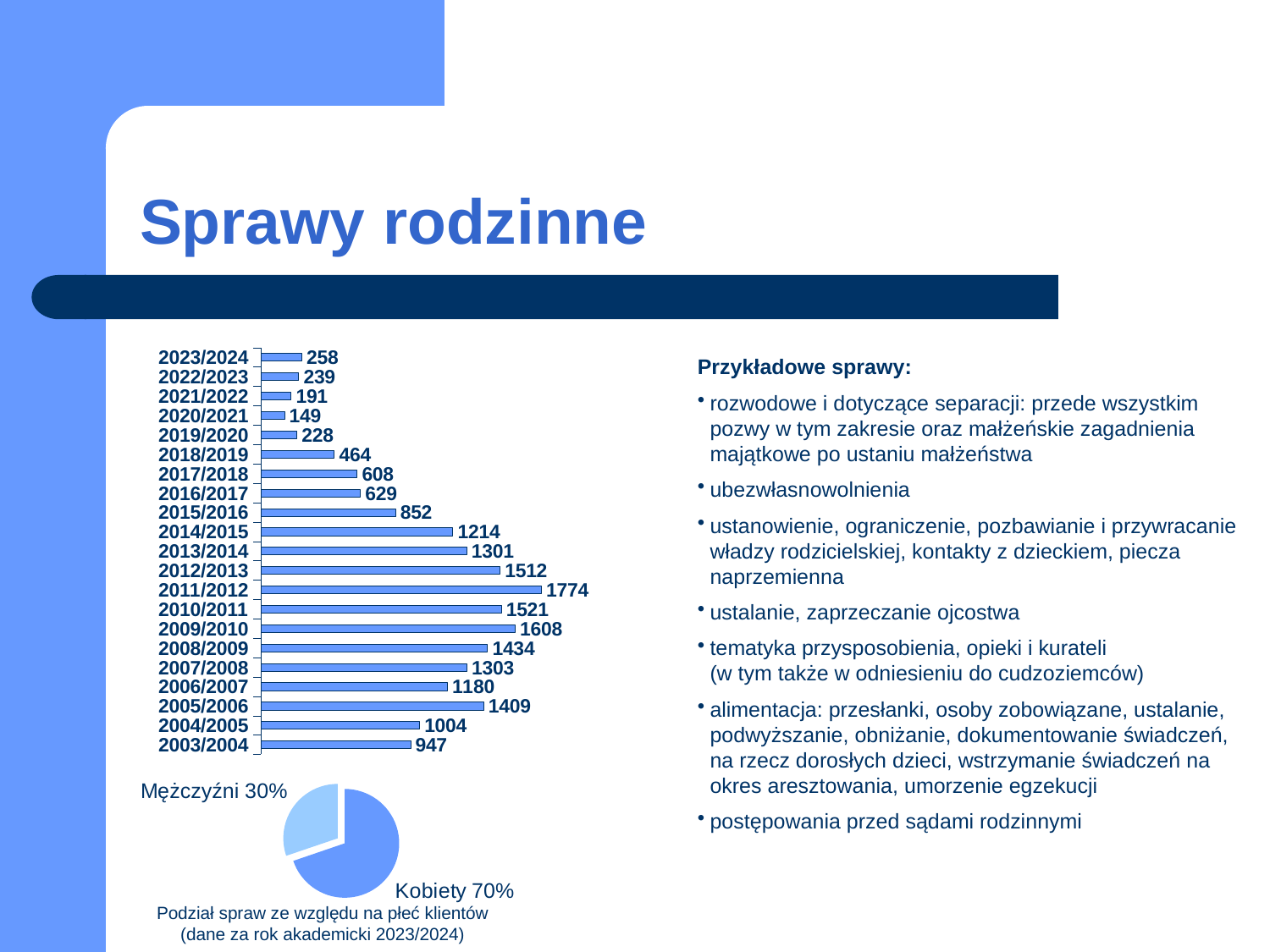
On the bar chart on the left, what is the value for 2023/2024? 258 On the bar chart on the left, what is the difference between the values for 2012/2013 and 2013/2014? 211 What is the title of the pie chart at the bottom left of the slide? Podział spraw ze względu na płeć klientów (dane za rok akademicki 2023/2024) On the bar chart on the left, what is the value for 2011/2012? 1774 How many academic years are shown on the bar chart on the left? 21 On the bar chart on the left, which is larger, the value for 2016/2017 or the value for 2017/2018? 2016/2017 On the bar chart on the left, which academic year has the lowest value? 2020/2021 On the bar chart on the left, which academic year has the highest value? 2011/2012 On the bar chart on the left, what is the value for 2003/2004? 947 What kind of chart is the chart on the upper left of the slide? bar chart On the pie chart at the bottom left, what share is labelled Kobiety? 70% On the pie chart at the bottom left, what share is labelled Mężczyźni? 30%